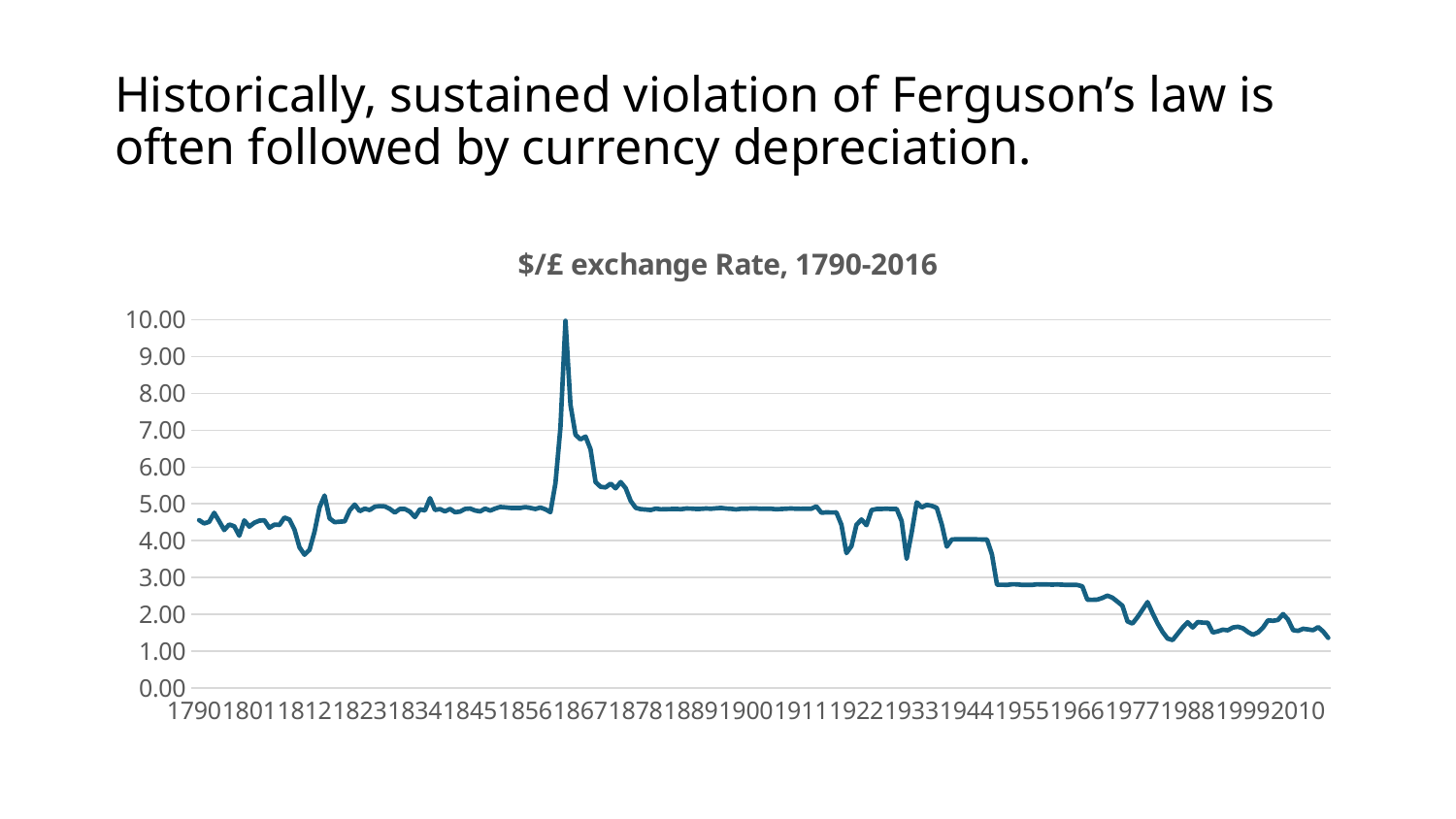
Is the value for 1790 greater or less than 4.00? greater Is the value for 1834 greater or less than 4.00? greater What kind of chart is shown on the slide? line chart Is the highest point on the line greater or less than 9.00? greater Overall, does the $/£ exchange rate rise or fall from 1790 to 2016? fall What is the highest value shown on the vertical axis? 10.00 Which is larger, the value for 1790 or the value for 2010? 1790 What is the title of the chart? $/£ exchange Rate, 1790-2016